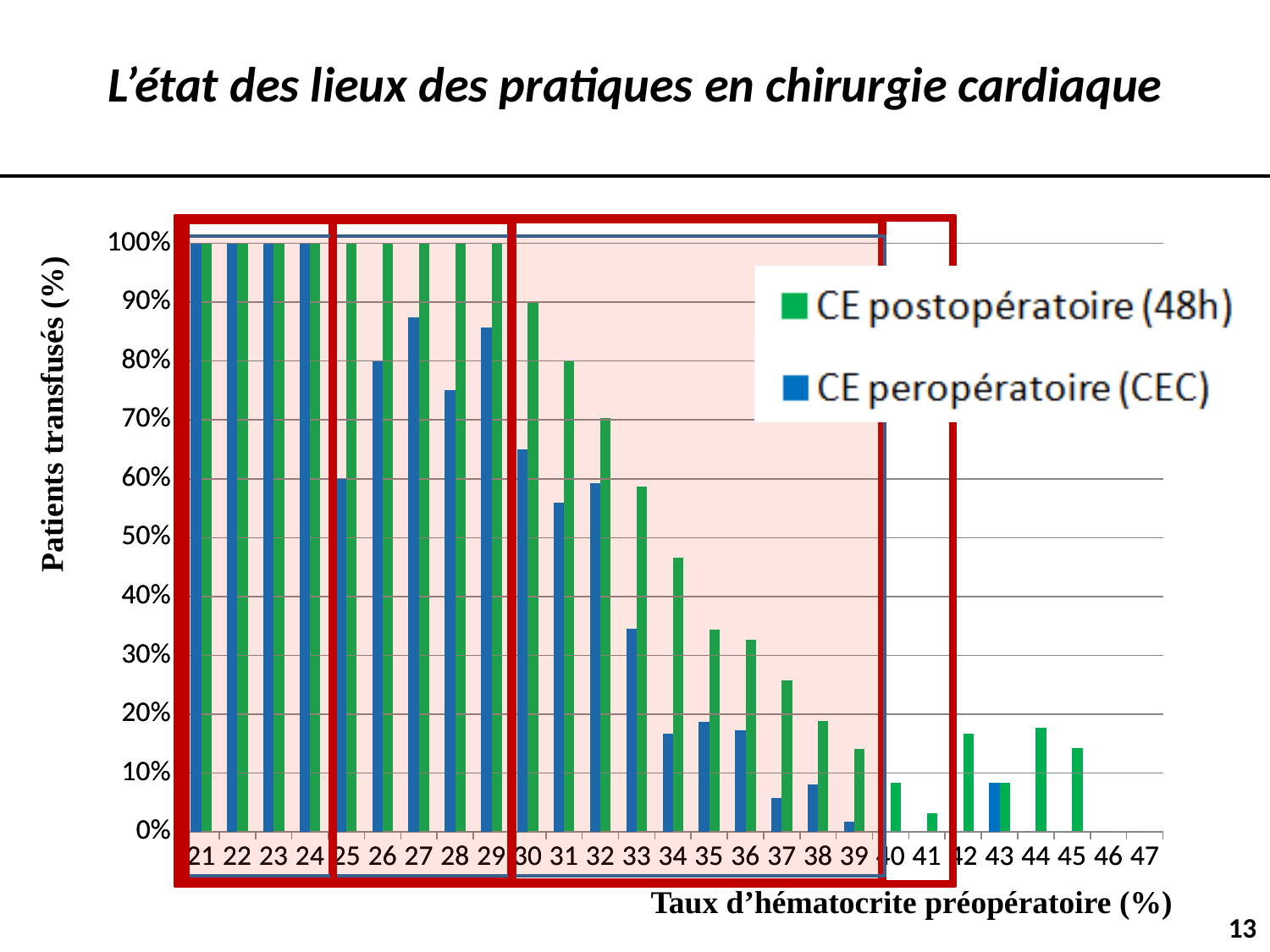
What is the value of CE postopératoire (48h) at a preoperative hematocrit of 21%? 100% Is the value of CE postopératoire (48h) at hematocrit 34 greater or less than 40%? greater Is the value of CE postopératoire (48h) at hematocrit 37 greater or less than 30%? less Is the value of CE peropératoire (CEC) at hematocrit 39 greater or less than 10%? less What is the value of CE peropératoire (CEC) at a preoperative hematocrit of 23%? 100% What colour represents CE peropératoire (CEC) in the legend? blue How many series does the legend list? 2 Do the CE postopératoire (48h) values generally rise or fall as the preoperative hematocrit increases? fall What kind of chart is shown on the slide? bar chart At hematocrit 33, which series has the larger value, CE postopératoire (48h) or CE peropératoire (CEC)? CE postopératoire (48h) How many hematocrit categories are shown on the x axis? 27